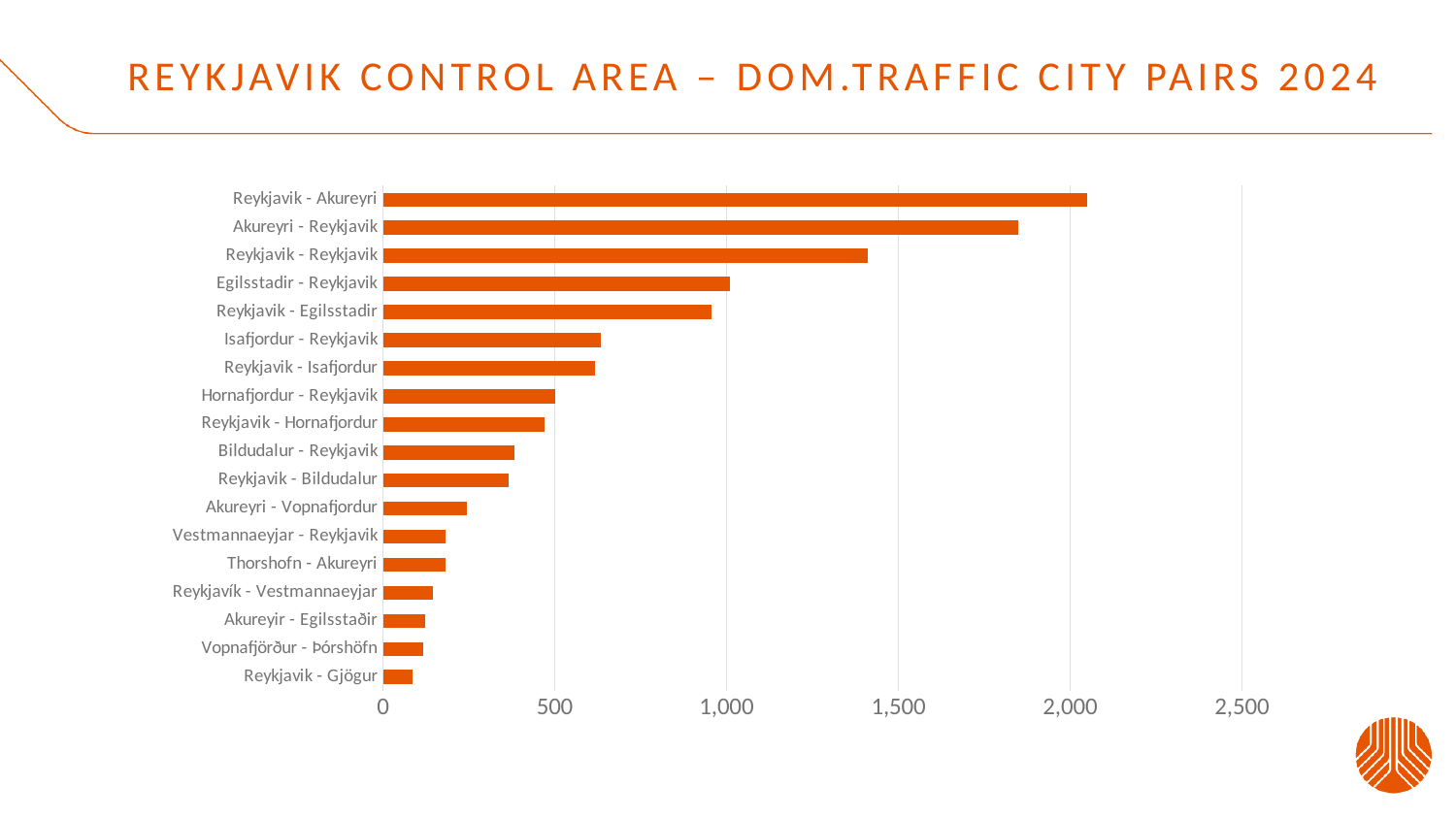
Is the value for Reykjavik - Reykjavik greater or less than 1,500? less Is the value for Bildudalur - Reykjavik greater or less than 500? less What type of chart is shown on the slide? bar chart Is the value for Isafjordur - Reykjavik greater or less than 500? greater Which is larger, the value for Reykjavik - Akureyri or the value for Akureyri - Reykjavik? Reykjavik - Akureyri Which city pair has the lowest value? Reykjavik - Gjögur How many city pairs are plotted in the chart? 18 What is the title of the chart? REYKJAVIK CONTROL AREA – DOM.TRAFFIC CITY PAIRS 2024 Which is larger, the value for Reykjavik - Isafjordur or the value for Akureyri - Vopnafjordur? Reykjavik - Isafjordur Which city pair has the highest value? Reykjavik - Akureyri